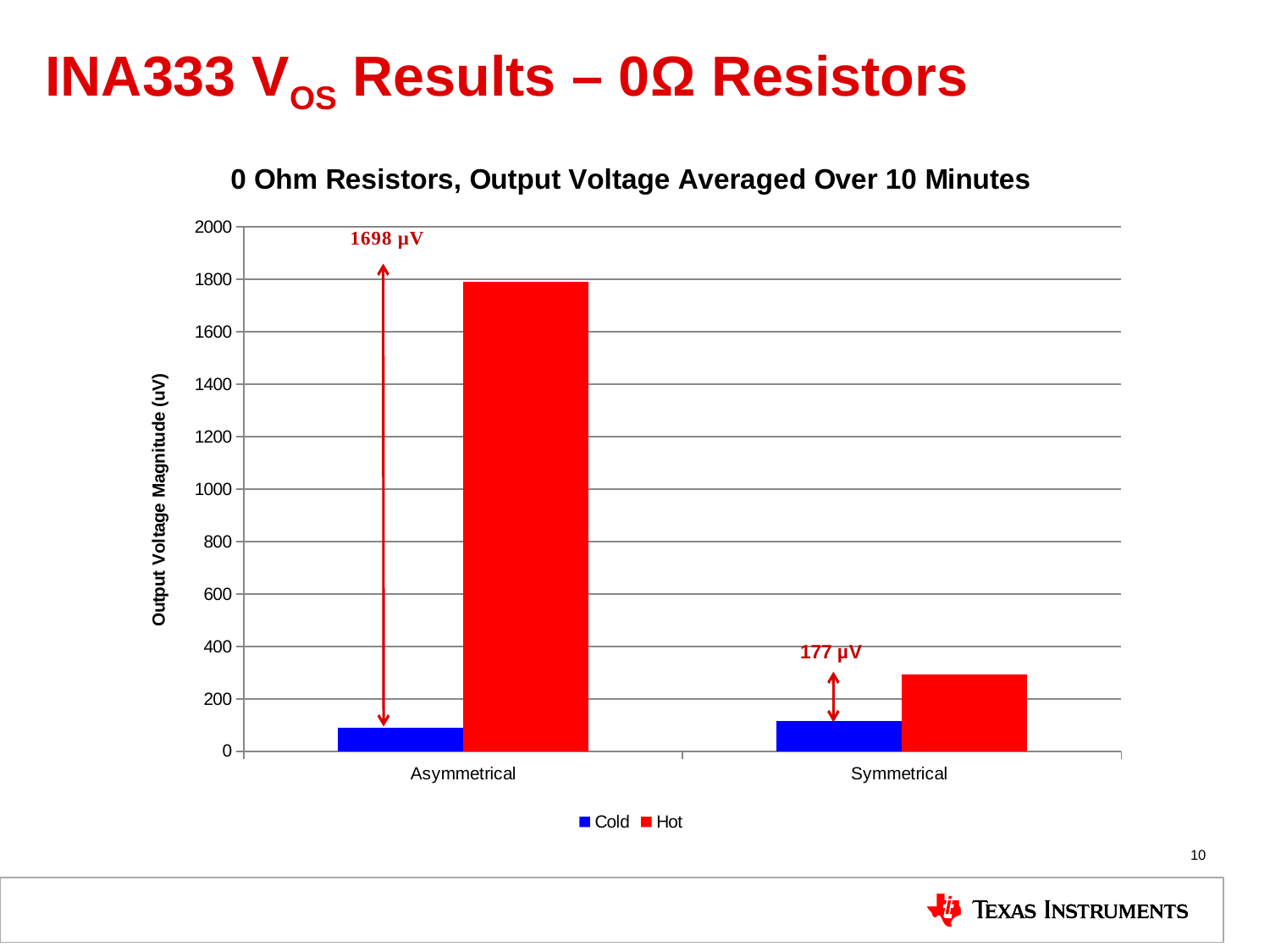
Is the Cold value for Asymmetrical greater or less than 200? less What is the annotated difference between the Hot and Cold bars for Symmetrical? 177 µV What kind of chart is shown on the slide? bar chart Which bar is the highest in the chart? Hot, Asymmetrical Is the Hot value for Symmetrical greater or less than 400? less What is the annotated difference between the Hot and Cold bars for Asymmetrical? 1698 µV How many series does the legend list? 2 How many categories are shown on the x axis? 2 For Symmetrical, which is larger, the Cold value or the Hot value? Hot Is the Hot value for Asymmetrical greater or less than 1600? greater What is the label of the vertical axis? Output Voltage Magnitude (uV) What is the title of the chart? 0 Ohm Resistors, Output Voltage Averaged Over 10 Minutes